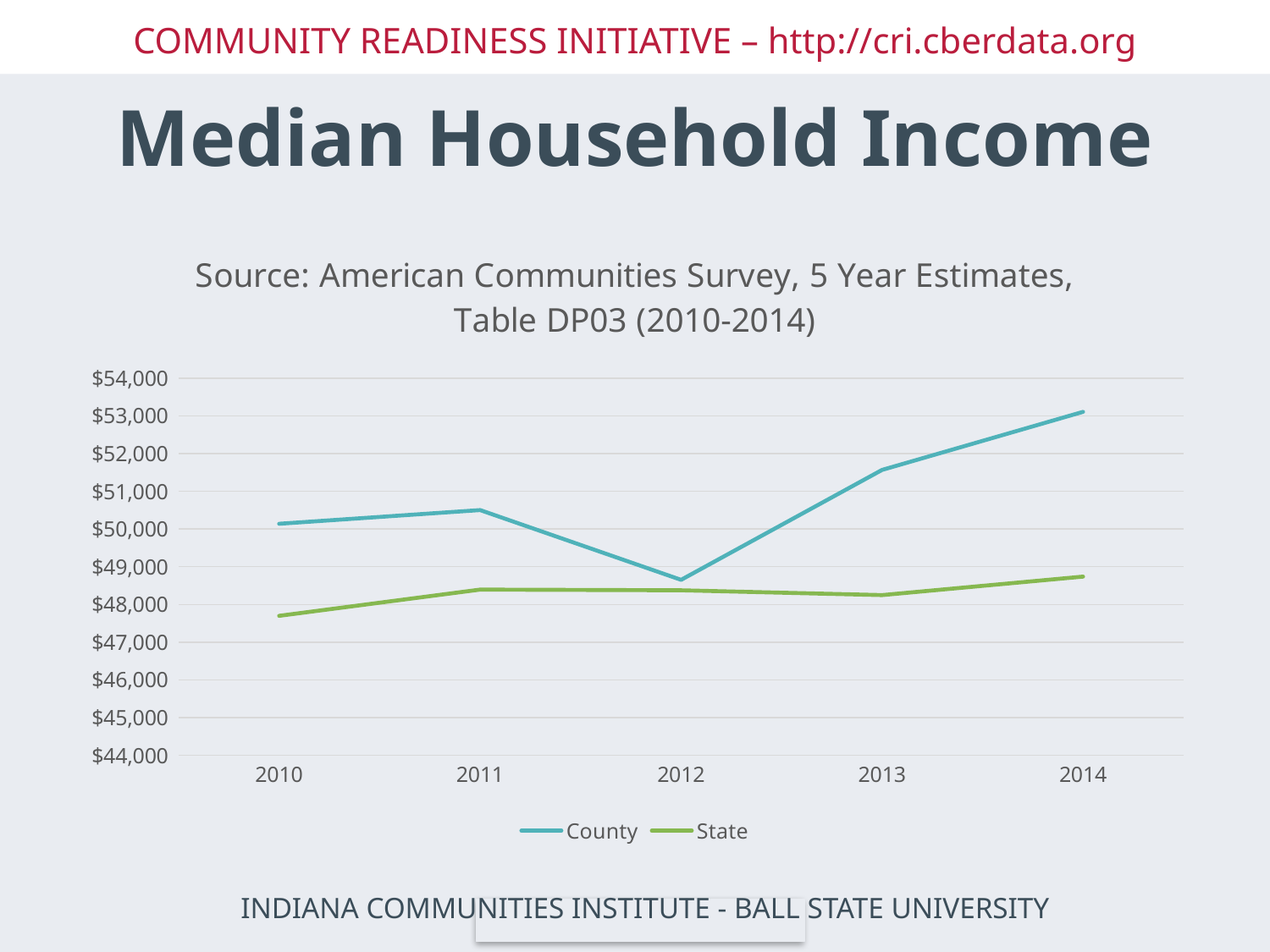
What kind of chart is shown on the slide? line chart Is the County value for 2012 greater or less than $49,000? less In which year is the County median household income highest? 2014 Which series has the higher value in 2014, County or State? County In which year is the State median household income lowest? 2010 How many years are plotted along the x axis? 5 How many series does the legend list? 2 In which year is the County median household income lowest? 2012 Is the County value for 2013 greater or less than $51,000? greater Does the County line rise or fall from 2012 to 2014? rise Is the County value for 2014 greater or less than $52,000? greater